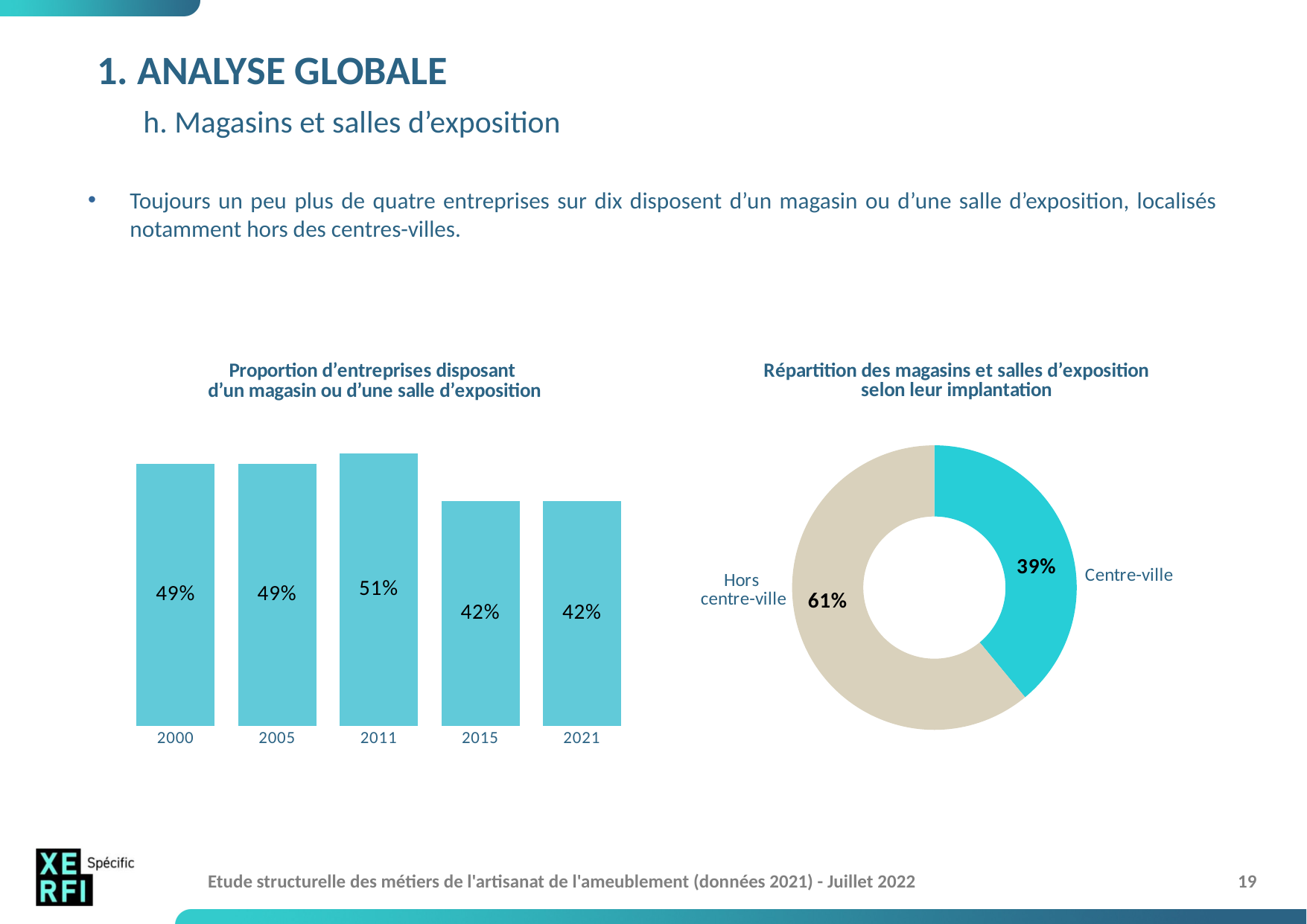
In the left chart 'Proportion d'entreprises disposant d'un magasin ou d'une salle d'exposition', what is the difference between the values for 2011 and 2015? 9 percentage points In the left chart 'Proportion d'entreprises disposant d'un magasin ou d'une salle d'exposition', what is the value for 2011? 51% In the right chart 'Répartition des magasins et salles d'exposition selon leur implantation', what share is 'Hors centre-ville'? 61% In the right chart 'Répartition des magasins et salles d'exposition selon leur implantation', what share is 'Centre-ville'? 39% How many years are shown in the left chart 'Proportion d'entreprises disposant d'un magasin ou d'une salle d'exposition'? 5 In the left chart 'Proportion d'entreprises disposant d'un magasin ou d'une salle d'exposition', what is the value for 2021? 42% In the left chart 'Proportion d'entreprises disposant d'un magasin ou d'une salle d'exposition', is the value for 2000 larger or smaller than the value for 2021? larger In the right chart 'Répartition des magasins et salles d'exposition selon leur implantation', which segment is larger, 'Centre-ville' or 'Hors centre-ville'? Hors centre-ville What kind of chart is the left chart 'Proportion d'entreprises disposant d'un magasin ou d'une salle d'exposition'? Bar chart What kind of chart is the right chart 'Répartition des magasins et salles d'exposition selon leur implantation'? Doughnut chart In the left chart 'Proportion d'entreprises disposant d'un magasin ou d'une salle d'exposition', which year has the highest value? 2011 In the left chart 'Proportion d'entreprises disposant d'un magasin ou d'une salle d'exposition', does the value rise or fall between 2011 and 2015? Fall